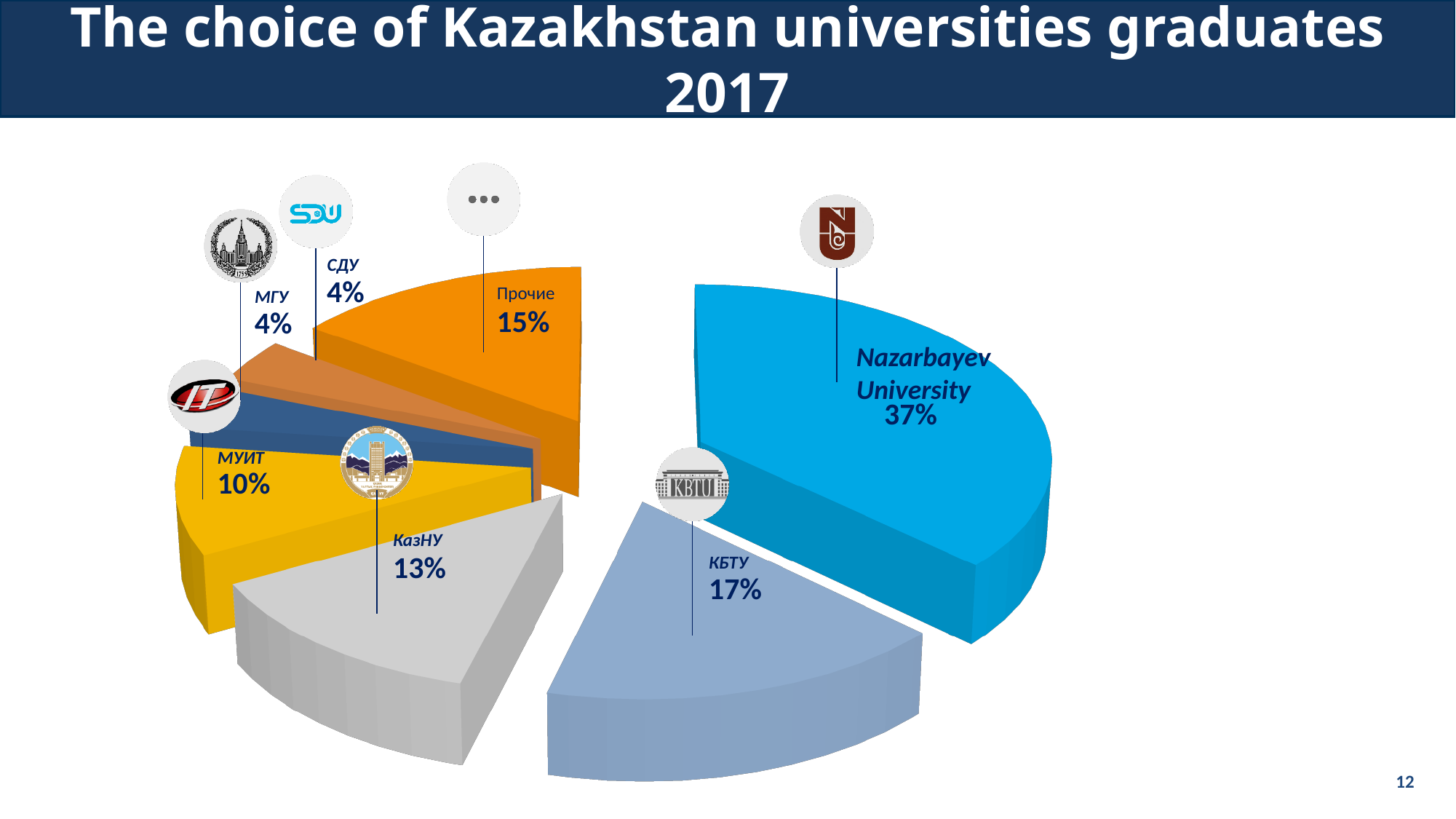
Which categories share the smallest slice of the pie? СДУ and МГУ What is the value for Прочие? 15% What kind of chart is shown on the slide? pie chart What is the value for МУИТ? 10% What is the title of the slide containing the chart? The choice of Kazakhstan universities graduates 2017 Which category has the largest slice of the pie? Nazarbayev University What is the value for КазНУ? 13% What is the value for КБТУ? 17% What is the difference between the shares of Nazarbayev University and КБТУ? 20% What share of graduates chose Nazarbayev University? 37% Which is larger, the share for КазНУ or the share for МУИТ? КазНУ How many slices does the pie chart have? 7